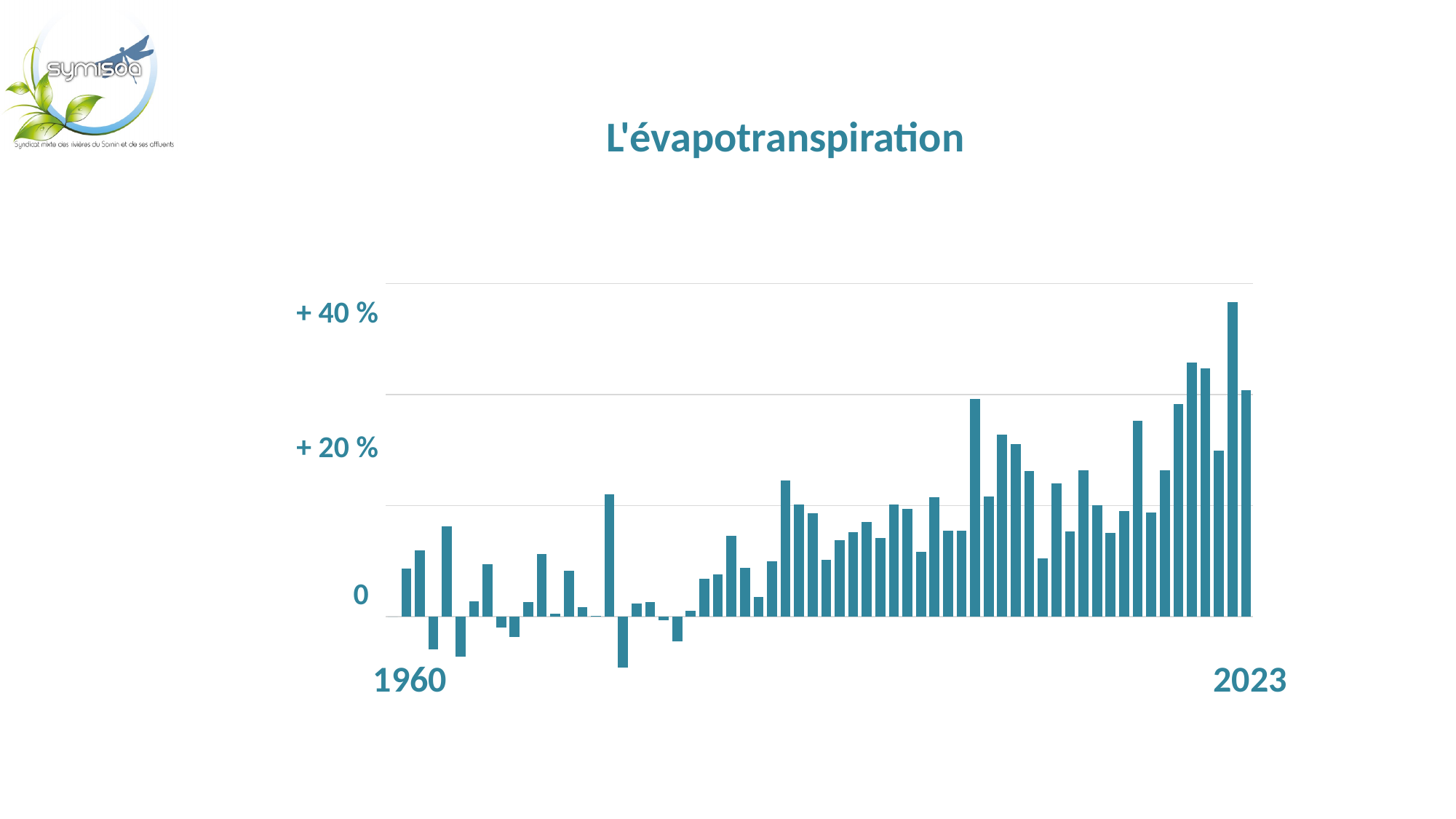
What is the title of the chart? L'évapotranspiration Which year has the larger value, 1960 or 2023? 2023 Is the value for 1960 greater or less than + 20 %? less How many data series are plotted in the chart? 1 What is the last year shown on the x axis of the chart? 2023 Does the chart contain any bars with values below 0? Yes What kind of chart is shown on the slide? Bar chart Do the values generally rise or fall from 1960 to 2023? rise Is the value for 2023 greater or less than + 20 %? greater